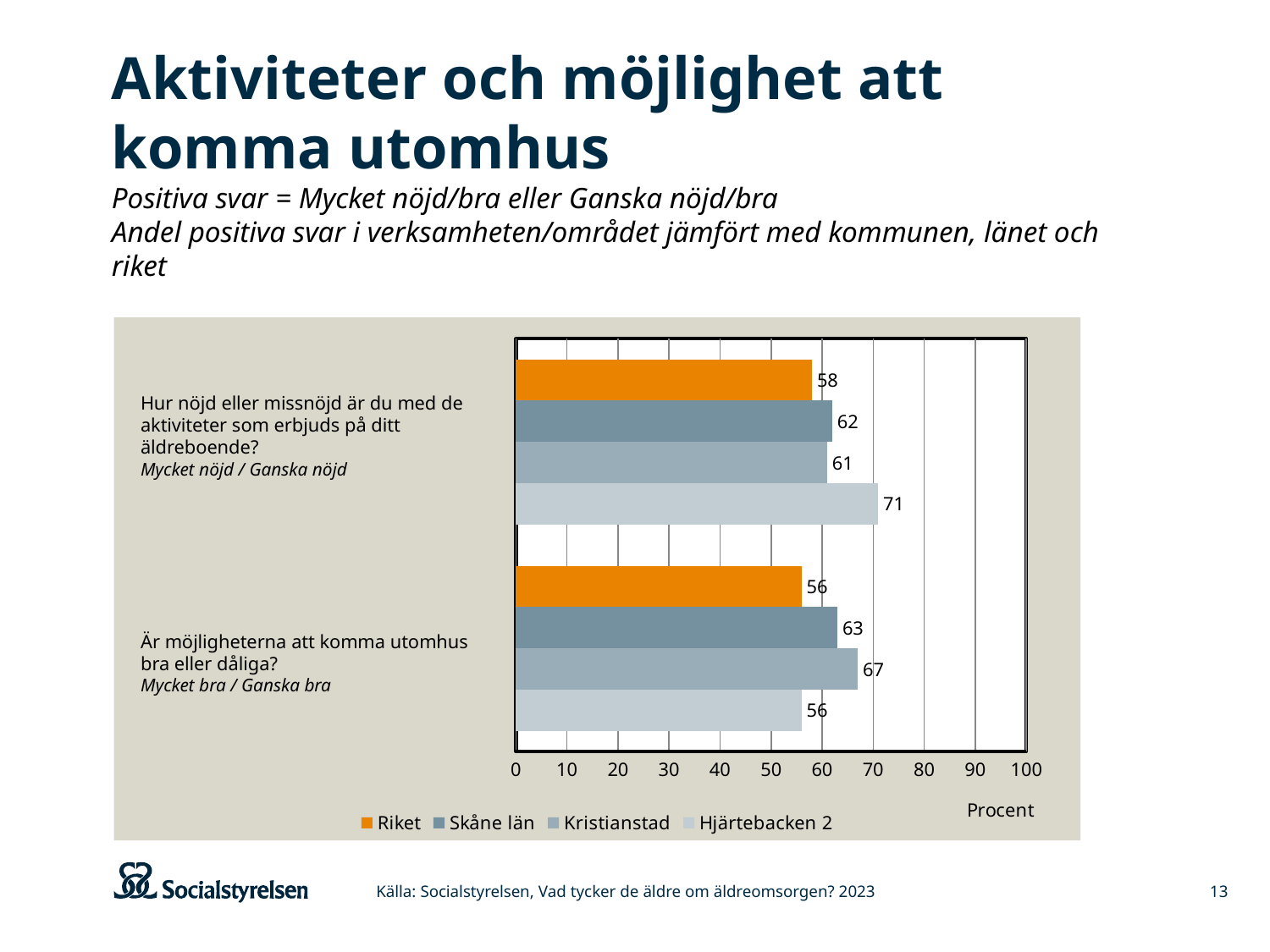
What is the difference between Hjärtebacken 2 and Riket for the question about activities offered at the care home? 13 What kind of chart is shown on the slide? Bar chart Which is larger for Hjärtebacken 2: the value for the activities question or the value for the outdoors question? The activities question Which series has the highest value for the question about opportunities to get outdoors? Kristianstad How many question categories are shown on the chart? 2 What is the value for Riket for the question about opportunities to get outdoors (Är möjligheterna att komma utomhus bra eller dåliga)? 56 What is the value for Kristianstad for the question about opportunities to get outdoors? 67 Which series has the lowest value for the question about activities offered at the care home? Riket Which series has the highest value for the question about activities offered at the care home? Hjärtebacken 2 How many series does the legend list? 4 What is the value for Hjärtebacken 2 for the question about activities offered at the care home (Hur nöjd eller missnöjd är du med de aktiviteter som erbjuds på ditt äldreboende)? 71 What is the value for Skåne län for the question about activities offered at the care home? 62